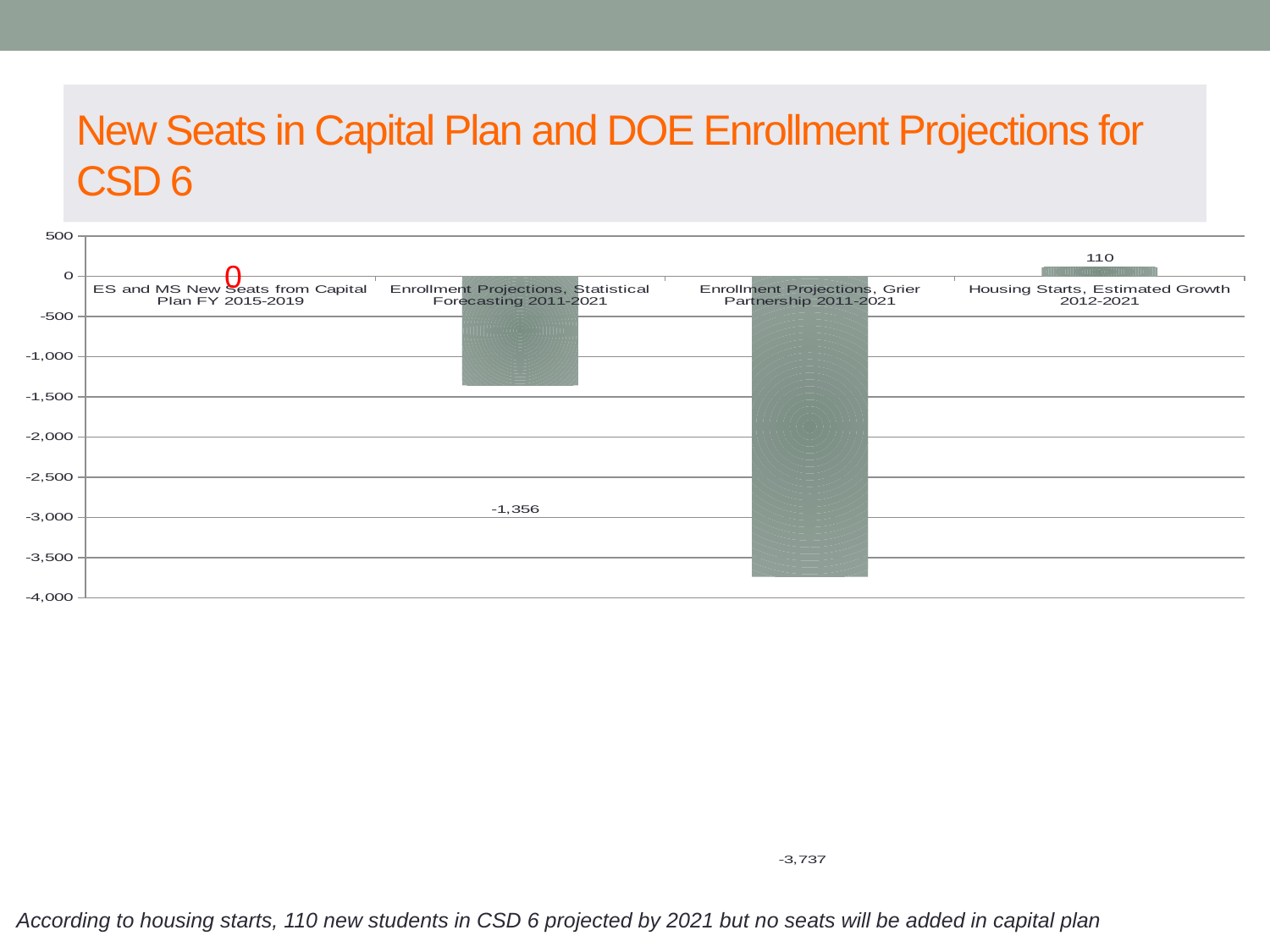
What kind of chart is shown on the slide? bar chart What is the difference between the Statistical Forecasting projection and the Grier Partnership projection? 2,381 What is the title of the slide containing the chart? New Seats in Capital Plan and DOE Enrollment Projections for CSD 6 What is the value for ES and MS New Seats from Capital Plan FY 2015-2019? 0 Which is larger, the value for Housing Starts, Estimated Growth 2012-2021 or the value for Enrollment Projections, Statistical Forecasting 2011-2021? Housing Starts, Estimated Growth 2012-2021 What is the value for Housing Starts, Estimated Growth 2012-2021? 110 Is the value for Enrollment Projections, Grier Partnership 2011-2021 greater or less than -3,000? less What is the value for Enrollment Projections, Grier Partnership 2011-2021? -3,737 Which category has the highest value? Housing Starts, Estimated Growth 2012-2021 What is the value for Enrollment Projections, Statistical Forecasting 2011-2021? -1,356 Which category has the lowest value? Enrollment Projections, Grier Partnership 2011-2021 How many categories are shown in the chart? 4